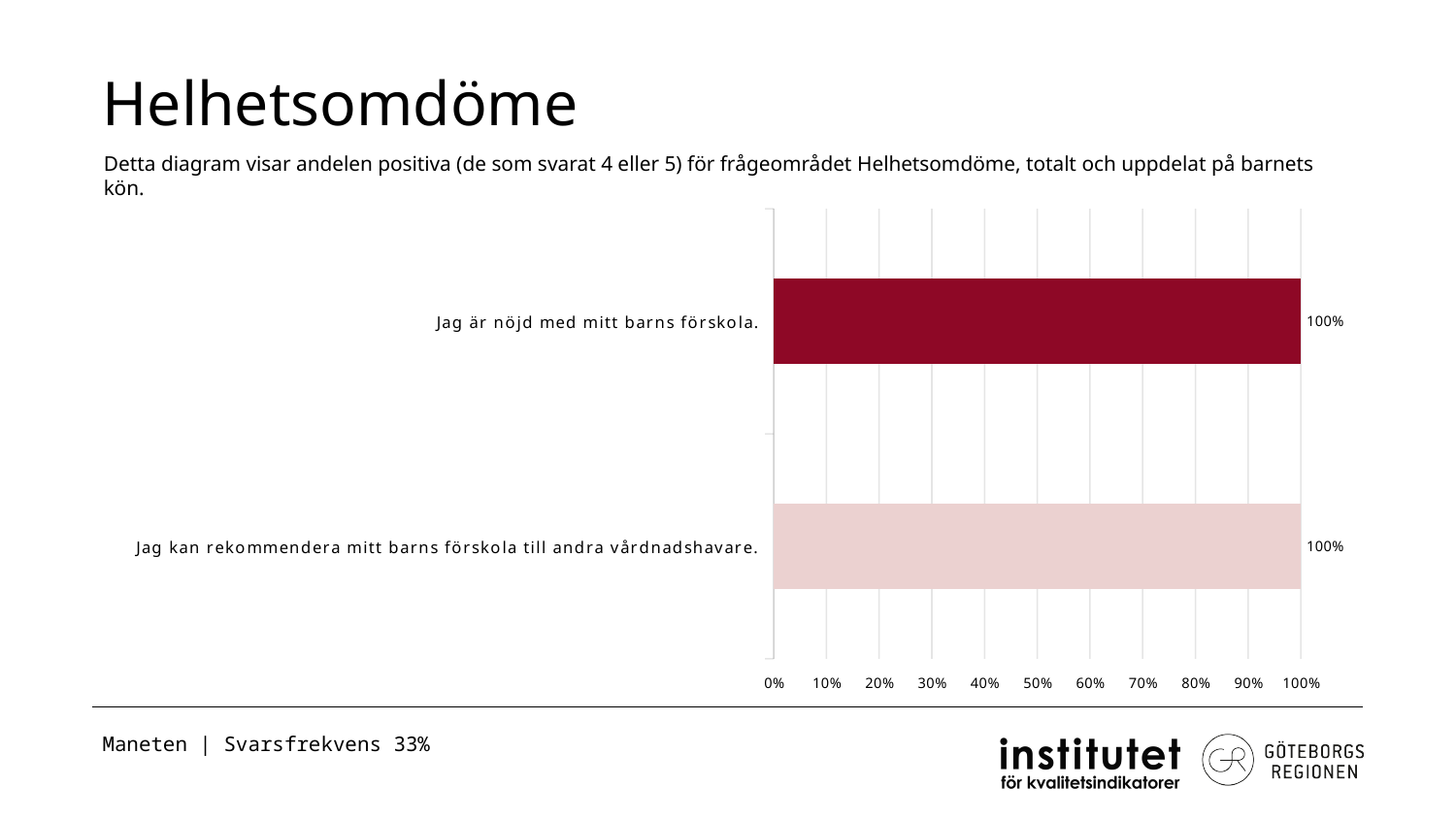
What is the value for "Jag är nöjd med mitt barns förskola."? 100% What is the difference between the values for "Jag är nöjd med mitt barns förskola." and "Jag kan rekommendera mitt barns förskola till andra vårdnadshavare."? 0% What is the title of the slide containing the chart? Helhetsomdöme How many categories are plotted in the chart? 2 Is the value for "Jag kan rekommendera mitt barns förskola till andra vårdnadshavare." greater or less than 90%? greater Is the value for "Jag är nöjd med mitt barns förskola." greater or less than 50%? greater What is the value for "Jag kan rekommendera mitt barns förskola till andra vårdnadshavare."? 100% What kind of chart is shown on the slide? Bar chart What is the highest value shown on the x axis of the chart? 100%